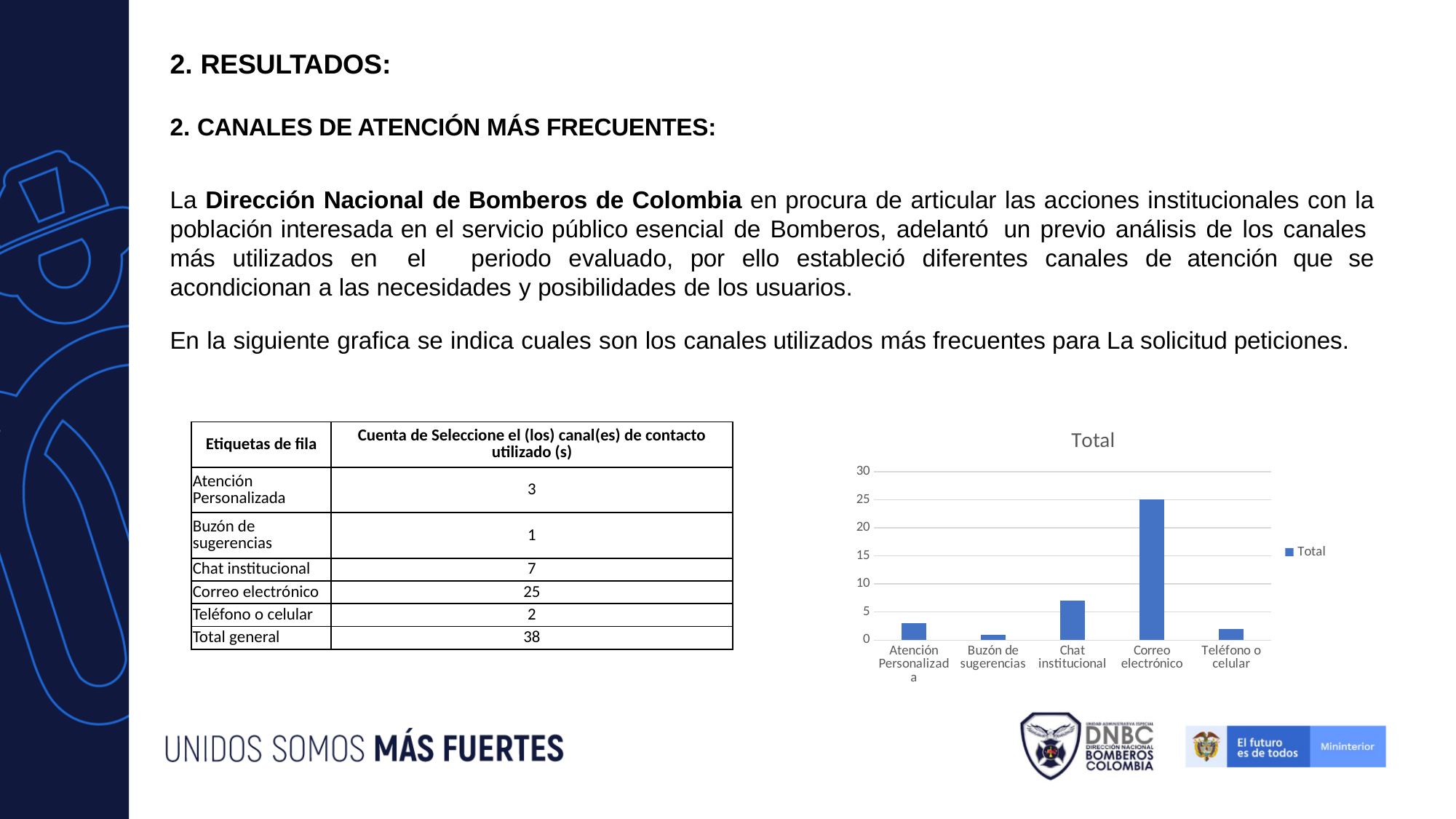
What type of chart is shown on the slide? bar chart Is the value for Correo electrónico greater or less than 20? greater How many series does the chart legend list? 1 What is the value for Correo electrónico? 25 Which category has the lowest value in the chart? Buzón de sugerencias What is the title of the chart? Total What is the difference between the values for Correo electrónico and Chat institucional? 18 Which category has the highest value in the chart? Correo electrónico How many categories are shown on the x axis of the chart? 5 What is the value for Chat institucional? 7 What is the value for Atención Personalizada? 3 Which is larger, the value for Chat institucional or the value for Teléfono o celular? Chat institucional